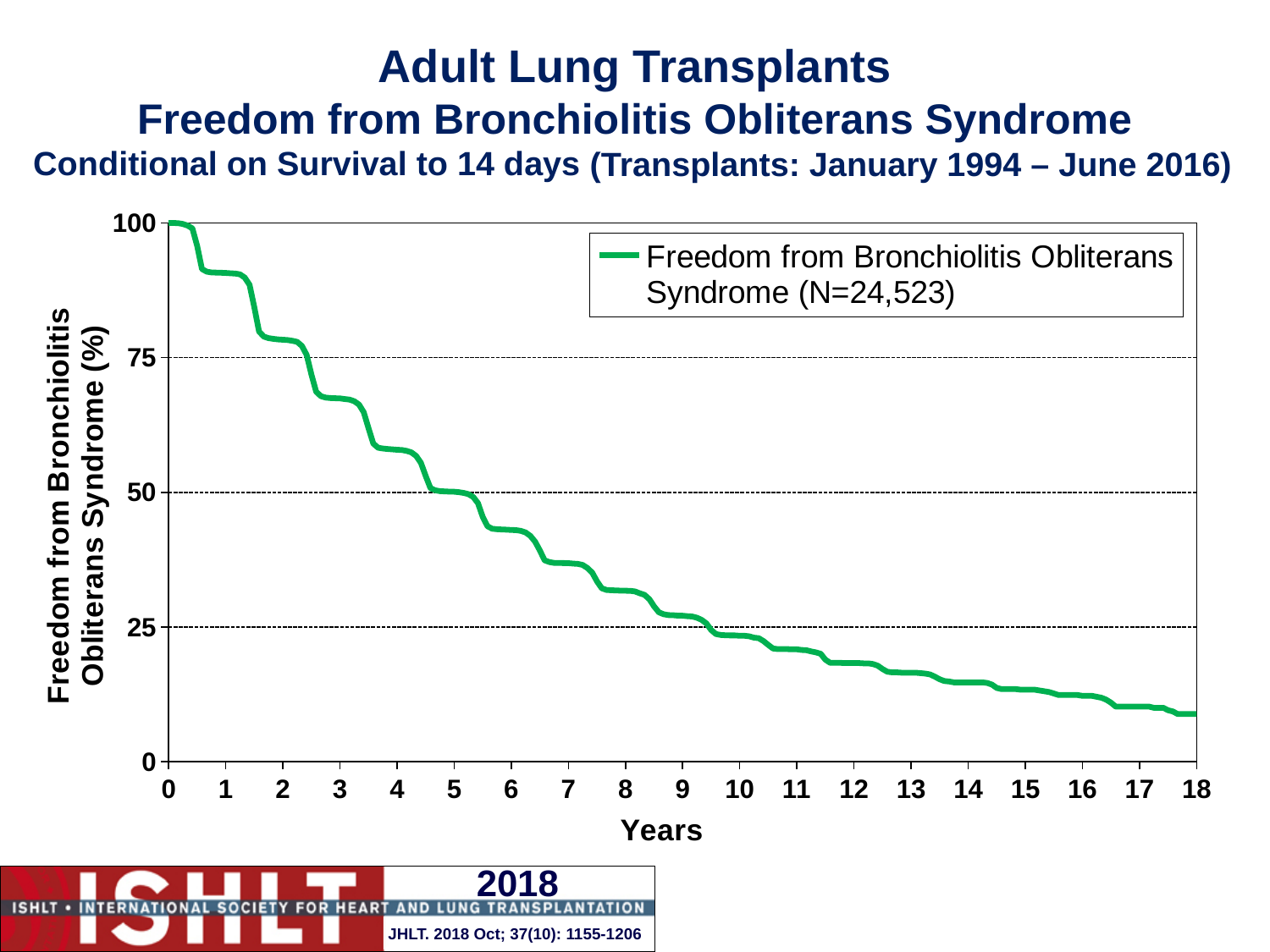
Is the value for freedom from Bronchiolitis Obliterans Syndrome at year 1 greater or less than 75? greater Is the value for freedom from Bronchiolitis Obliterans Syndrome at year 7 greater or less than 25? greater Is the value for freedom from Bronchiolitis Obliterans Syndrome at year 12 greater or less than 25? less What kind of chart is shown on the slide? line chart How many series does the legend list? 1 What is the N value given in the legend for the plotted series? N=24,523 Do the values rise or fall as the years increase along the x axis? fall What is the value of freedom from Bronchiolitis Obliterans Syndrome at year 0? 100 What is the label of the x axis? Years